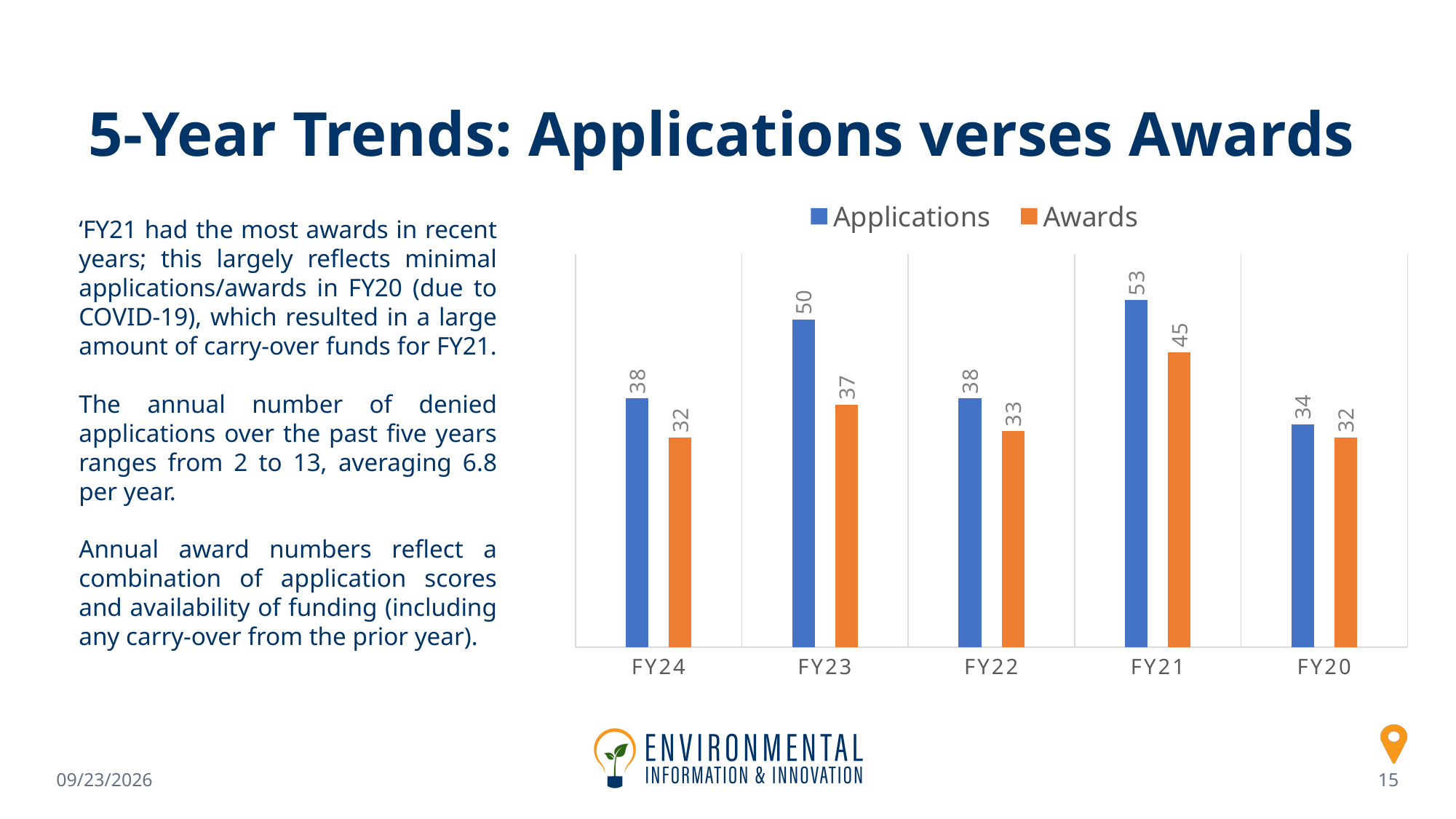
What kind of chart is shown on the slide? Bar chart What is the number of Awards for FY21? 45 Which is larger: Awards in FY22 or Awards in FY23? Awards in FY23 What is the difference between Applications and Awards in FY21? 8 Which fiscal year has the lowest number of Applications? FY20 What is the difference between Applications and Awards in FY23? 13 How many series does the legend list? 2 What is the number of Awards for FY24? 32 Which colour represents the Awards series? Orange How many fiscal years are shown on the x axis? 5 What is the number of Applications for FY23? 50 Which fiscal year has the highest number of Applications? FY21